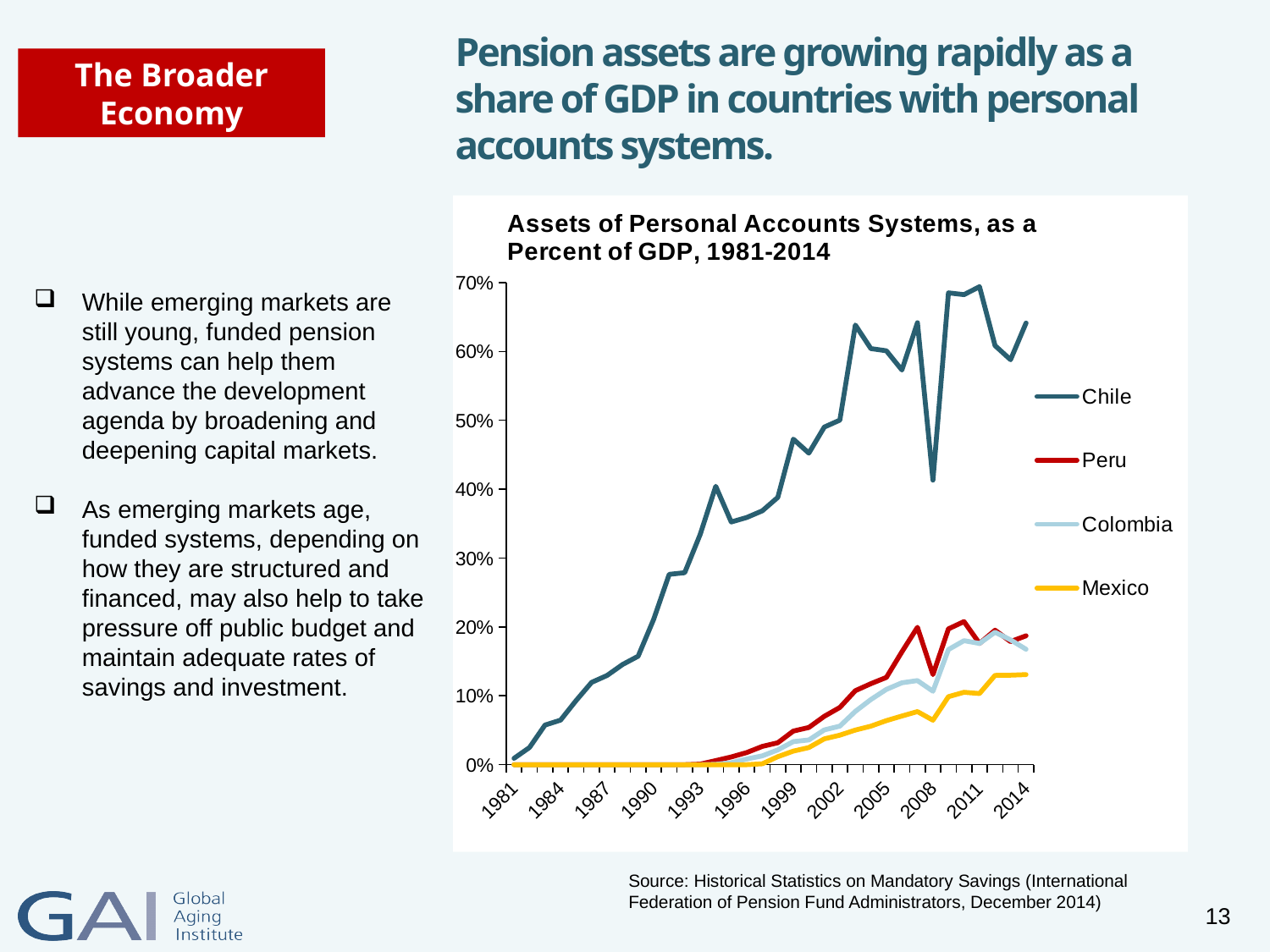
What is the title of the chart? Assets of Personal Accounts Systems, as a Percent of GDP, 1981-2014 Which country has the highest assets of personal accounts systems as a percent of GDP in 2014? Chile Is the value for Mexico in 2014 greater or less than 20%? less Is the value for Chile in 2008 greater or less than 50%? less How many series does the chart's legend list? 4 Does the value for Chile generally rise or fall from 1981 to 2014? rise Which country has the lowest assets of personal accounts systems as a percent of GDP in 2014? Mexico Is the value for Chile in 2014 greater or less than 60%? greater In 2014, which is larger: the value for Chile or the value for Mexico? Chile What kind of chart is shown on the slide? line chart In 2014, which is larger: the value for Peru or the value for Mexico? Peru